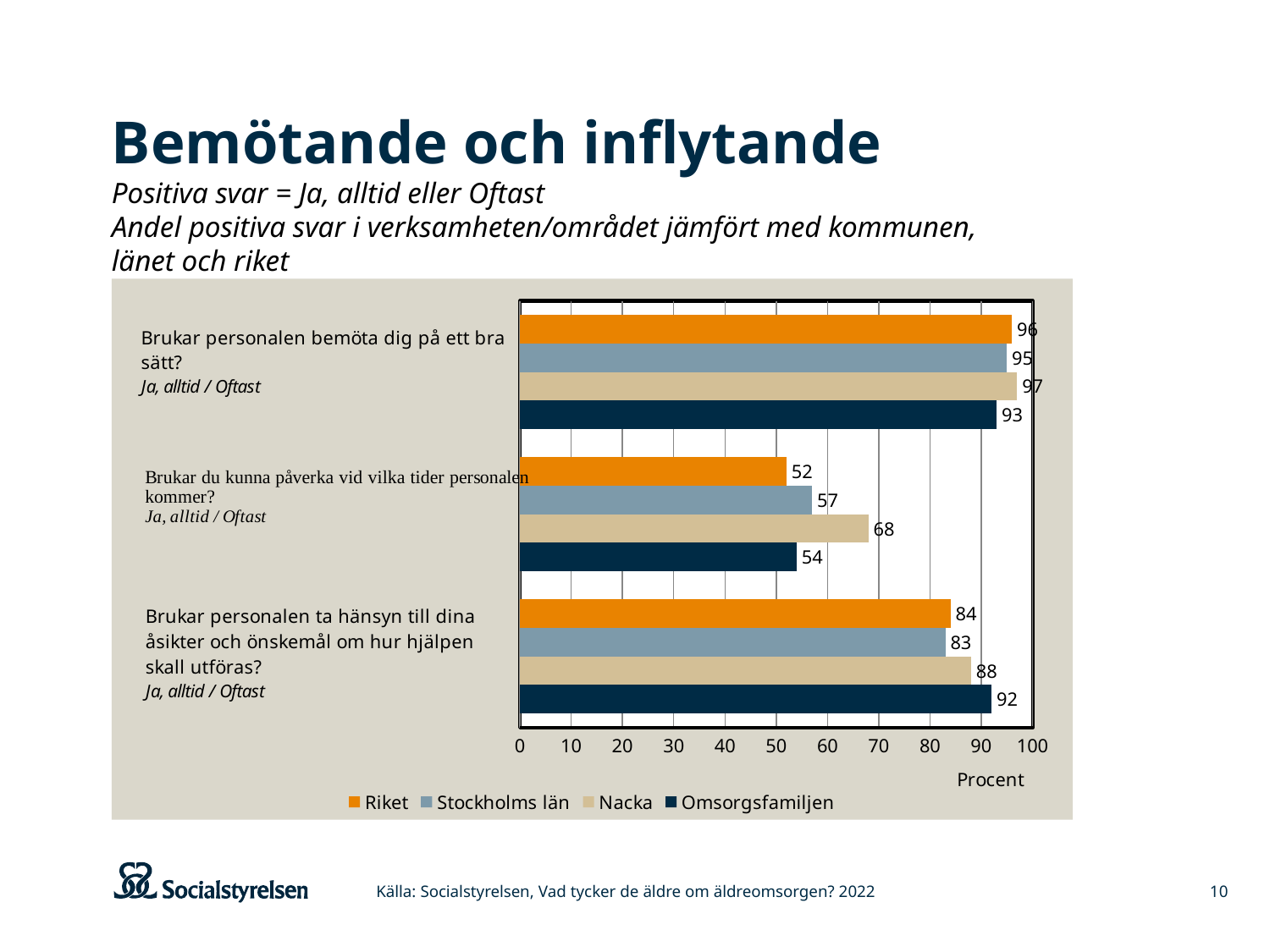
Which series has the lowest value on the question "Brukar personalen ta hänsyn till dina åsikter och önskemål om hur hjälpen skall utföras?"? Stockholms län How many series does the legend list? 4 How many question categories are plotted on the chart? 3 What is the value for Nacka on the question "Brukar du kunna påverka vid vilka tider personalen kommer?"? 68 Which is larger on the question "Brukar personalen ta hänsyn till dina åsikter och önskemål om hur hjälpen skall utföras?": Omsorgsfamiljen or Nacka? Omsorgsfamiljen What is the difference between Nacka and Riket on the question "Brukar du kunna påverka vid vilka tider personalen kommer?"? 16 What kind of chart is shown on the slide? Bar chart Which series has the highest value on the question "Brukar du kunna påverka vid vilka tider personalen kommer?"? Nacka What is the label of the x axis? Procent What is the value for Riket on the question "Brukar personalen ta hänsyn till dina åsikter och önskemål om hur hjälpen skall utföras?"? 84 What is the value for Omsorgsfamiljen on the question "Brukar personalen bemöta dig på ett bra sätt?"? 93 Is the value for Stockholms län on the question "Brukar du kunna påverka vid vilka tider personalen kommer?" greater or less than 60? less